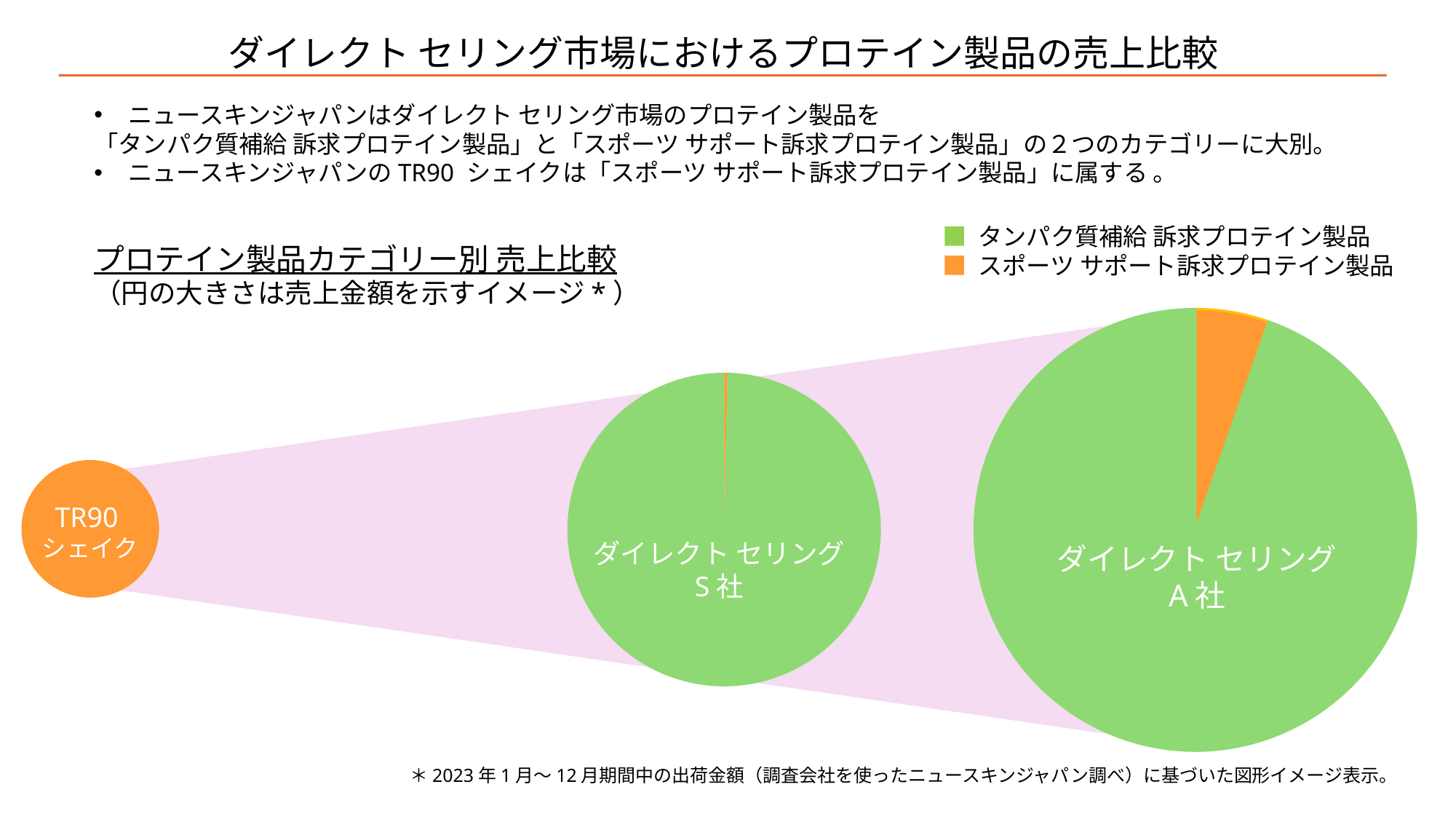
スライド上に描かれている円はいくつありますか？ 3 3つの円のうち、最も小さい円はどれですか？ TR90 シェイク 凡例にはいくつの系列（カテゴリー）が示されていますか？ 2 凡例でオレンジ色が示すカテゴリーは何ですか？ スポーツ サポート訴求プロテイン製品 「ダイレクト セリング A 社」の円グラフで、大部分を占めるカテゴリーはどちらですか？ タンパク質補給 訴求プロテイン製品 「ダイレクト セリング S 社」と「ダイレクト セリング A 社」の円では、どちらが大きいですか？ ダイレクト セリング A 社 3つの円のうち、最も大きい円はどれですか？ ダイレクト セリング A 社 このスライドのグラフの種類は何ですか？ 円グラフ 「ダイレクト セリング S 社」の円グラフで、最も小さい割合のカテゴリーはどちらですか？ スポーツ サポート訴求プロテイン製品 「TR90 シェイク」の円は、凡例のどのカテゴリーの色で塗られていますか？ スポーツ サポート訴求プロテイン製品 「ダイレクト セリング S 社」と「ダイレクト セリング A 社」のうち、スポーツ サポート訴求プロテイン製品の割合が大きいのはどちらですか？ ダイレクト セリング A 社 凡例で緑色が示すカテゴリーは何ですか？ タンパク質補給 訴求プロテイン製品